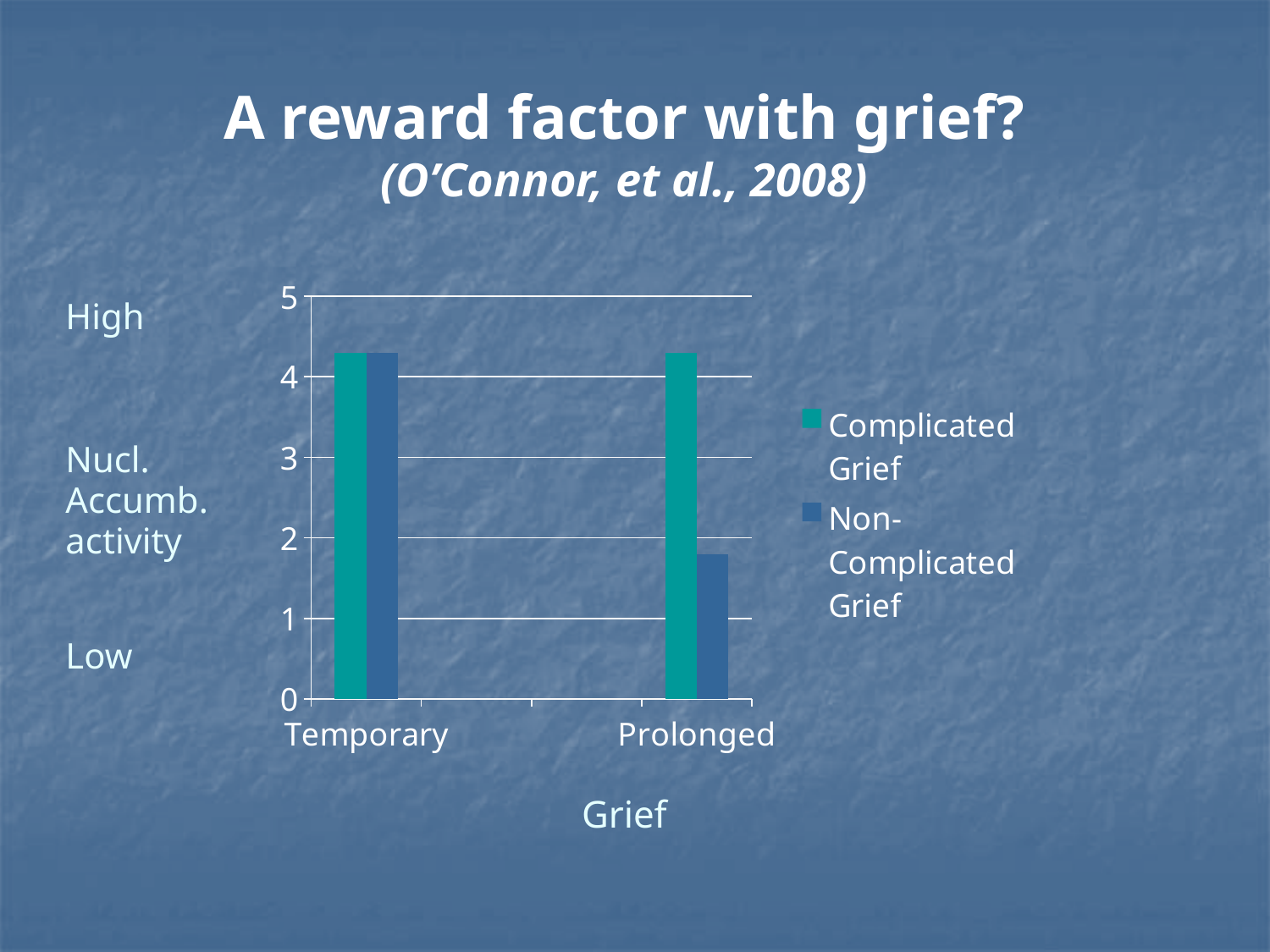
What kind of chart is shown on the slide? bar chart Does the Non-Complicated Grief series rise or fall from Temporary to Prolonged? fall Is the value for Complicated Grief in the Temporary category greater or less than 4? greater What is the title of the x axis of the chart? Grief For the Prolonged category, which series has the larger value: Complicated Grief or Non-Complicated Grief? Complicated Grief How many categories are shown on the x axis of the chart? 2 How many series does the chart's legend list? 2 Is the value for Non-Complicated Grief in the Temporary category greater or less than 3? greater Which two series are listed in the chart's legend? Complicated Grief and Non-Complicated Grief Is the value for Non-Complicated Grief in the Prolonged category greater or less than 3? less Which bar in the chart is the lowest? Non-Complicated Grief for Prolonged